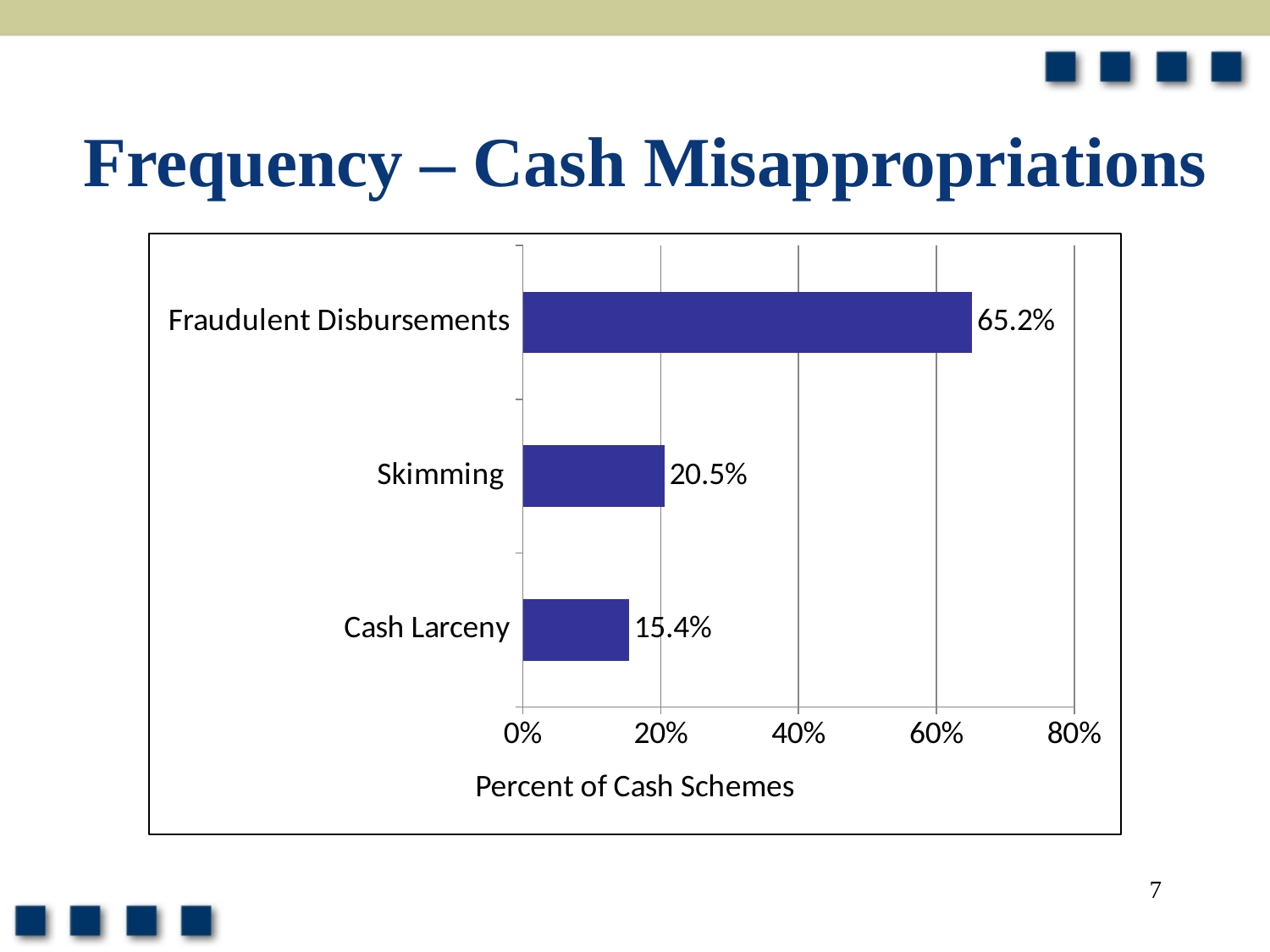
What is the value for Fraudulent Disbursements? 65.2% How many categories are shown in the chart? 3 What is the value for Cash Larceny? 15.4% Which category has the highest value? Fraudulent Disbursements Is the value for Fraudulent Disbursements greater or less than 60%? greater What is the value for Skimming? 20.5% What is the label on the horizontal axis of the chart? Percent of Cash Schemes Which is larger, the value for Skimming or the value for Cash Larceny? Skimming Which category has the lowest value? Cash Larceny What is the difference between the values for Skimming and Cash Larceny? 5.1% What kind of chart is shown on the slide? bar chart What is the difference between the values for Fraudulent Disbursements and Skimming? 44.7%